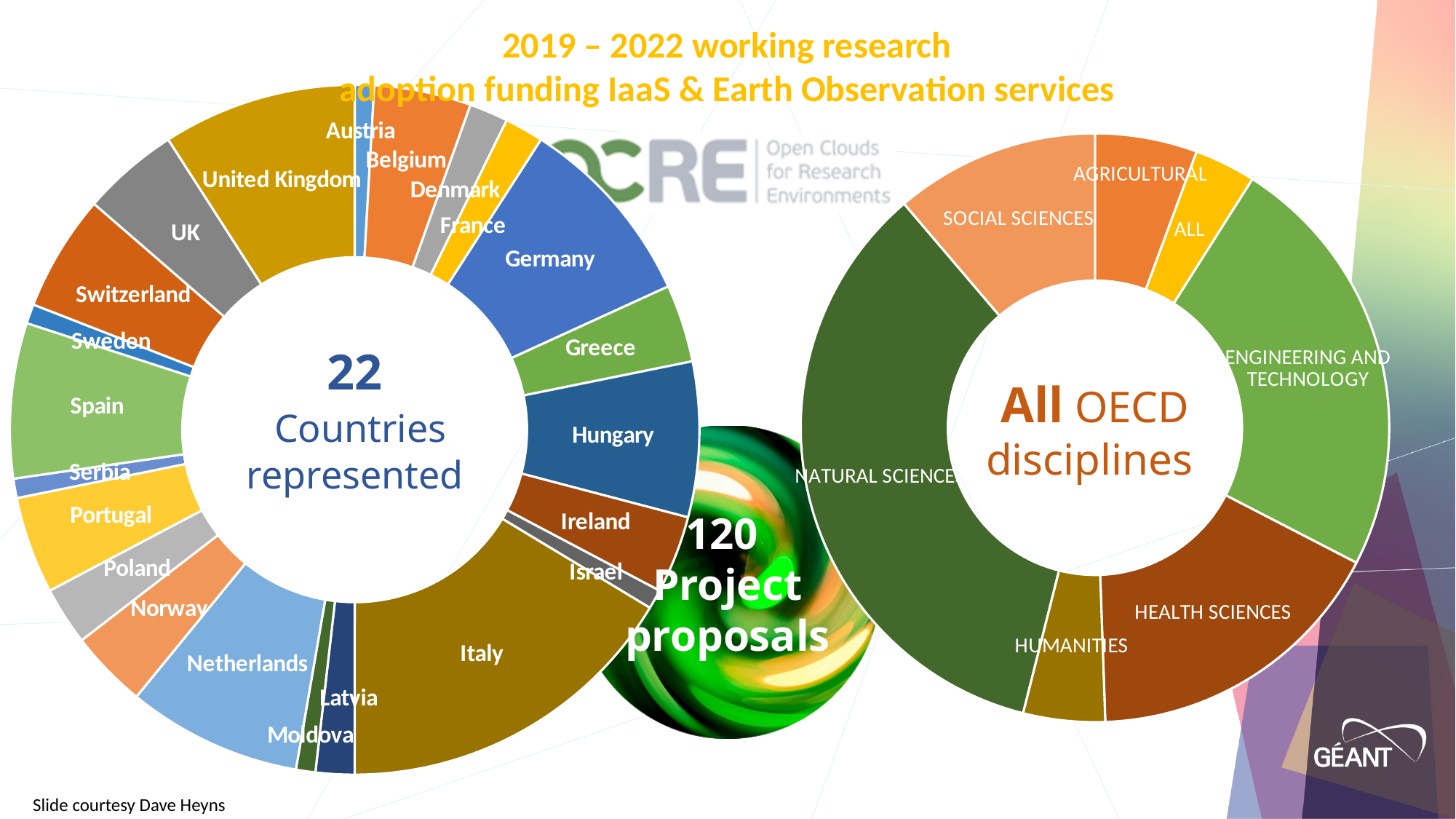
What kind of chart is the left chart showing countries represented? Donut chart In the left chart, which segment is larger, Italy or Germany? Italy What is the title shown at the top of the slide above the charts? 2019 – 2022 working research adoption funding IaaS & Earth Observation services In the left chart, which segment is larger, Spain or Serbia? Spain In the right chart, which discipline has the largest segment? Natural Sciences What text appears in the centre of the right chart? All OECD disciplines In the right chart, which segment is larger, Natural Sciences or Health Sciences? Natural Sciences In the left chart, how many countries are represented according to the text in its centre? 22 What kind of chart is the right chart showing OECD disciplines? Donut chart In the right chart, how many discipline segments are labelled? 7 In the left chart, which country has the largest segment? Italy